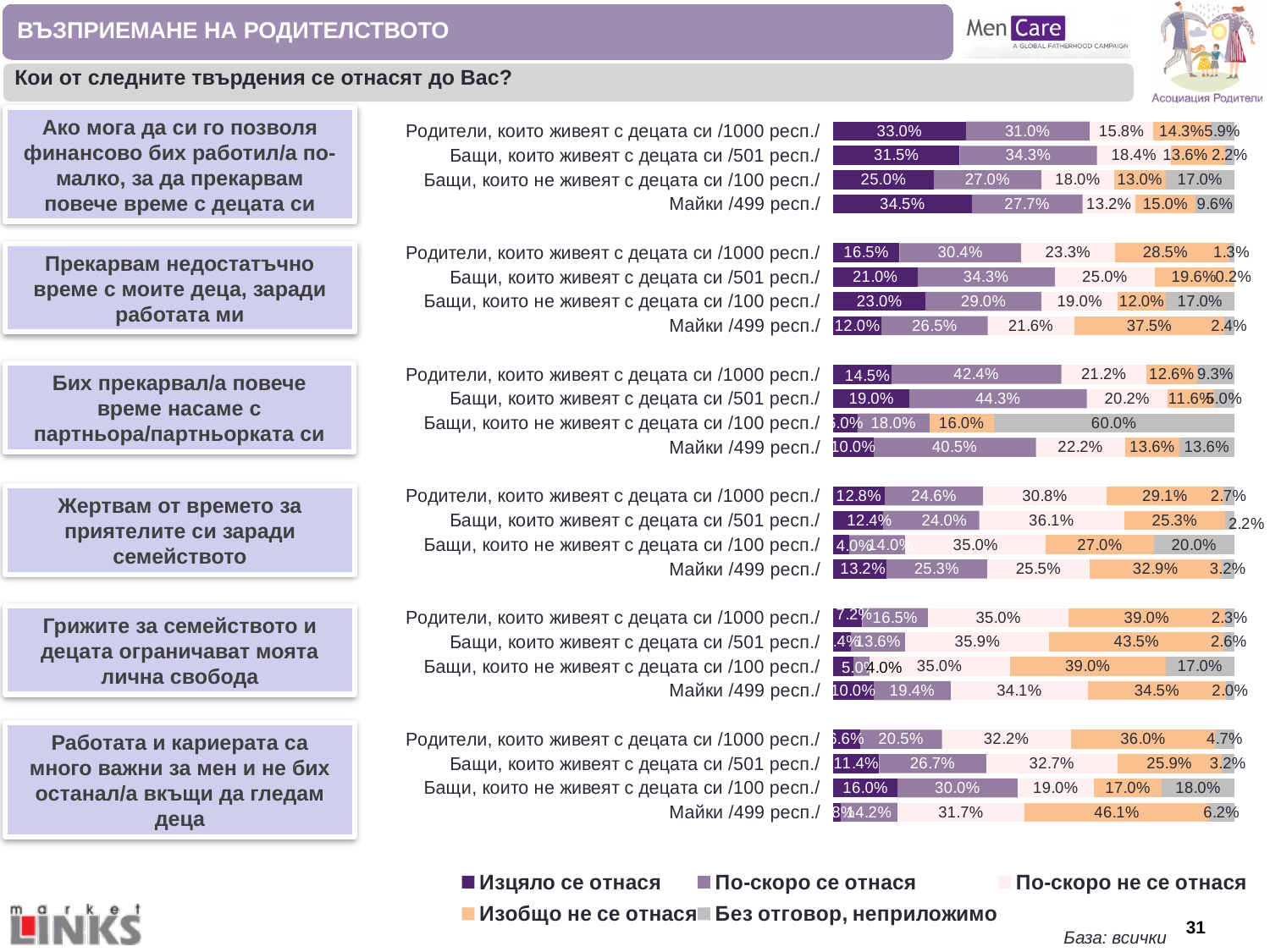
In the chart for 'Бих прекарвал/а повече време насаме с партньора/партньорката си', what is the 'По-скоро се отнася' value for 'Бащи, които живеят с децата си /501 респ./'? 44.3% In the chart for 'Жертвам от времето за приятелите си заради семейството', what is the 'По-скоро не се отнася' value for 'Бащи, които живеят с децата си /501 респ./'? 36.1% What kind of chart is used on the slide? Stacked bar chart In the chart for 'Работата и кариерата са много важни за мен и не бих останал/а вкъщи да гледам деца', what is the 'Изобщо не се отнася' value for 'Майки /499 респ./'? 46.1% In the chart for 'Прекарвам недостатъчно време с моите деца, заради работата ми', what is the difference between the 'Изцяло се отнася' values for 'Бащи, които не живеят с децата си /100 респ./' and 'Майки /499 респ./'? 11.0% In the chart for 'Бих прекарвал/а повече време насаме с партньора/партньорката си', what is the 'Без отговор, неприложимо' value for 'Бащи, които не живеят с децата си /100 респ./'? 60.0% In the chart for 'Ако мога да си го позволя финансово бих работил/а по-малко, за да прекарвам повече време с децата си', what is the 'Изцяло се отнася' value for 'Майки /499 респ./'? 34.5% In the chart for 'Грижите за семейството и децата ограничават моята лична свобода', which category has the highest 'Изобщо не се отнася' value? Бащи, които живеят с децата си /501 респ./ How many categories (rows) does each chart on the slide show? 4 In the chart for 'Ако мога да си го позволя финансово бих работил/а по-малко, за да прекарвам повече време с децата си', which is larger: the 'По-скоро се отнася' value for 'Бащи, които живеят с децата си /501 респ./' or for 'Майки /499 респ./'? Бащи, които живеят с децата си /501 респ./ In the chart for 'Прекарвам недостатъчно време с моите деца, заради работата ми', what is the 'Изобщо не се отнася' value for 'Майки /499 респ./'? 37.5% How many series does the legend list? 5